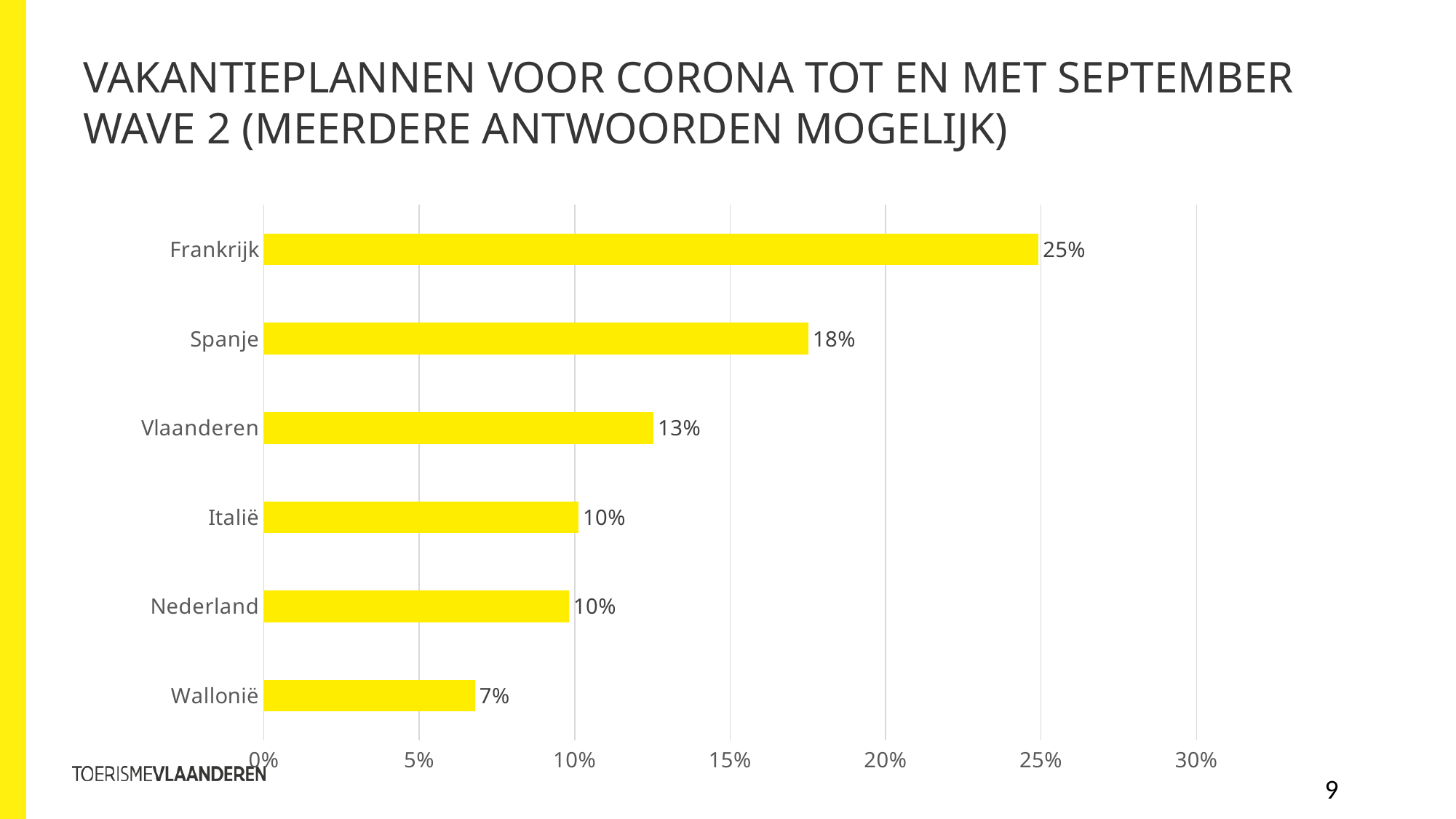
What is the value for Spanje? 18% What is the value for Vlaanderen? 13% How many categories are shown in the chart? 6 Which category has the highest value? Frankrijk Which category has the lowest value? Wallonië What is the difference between the values for Vlaanderen and Wallonië? 6% What kind of chart is shown on the slide? Bar chart What is the value for Frankrijk? 25% Which is larger, the value for Spanje or the value for Vlaanderen? Spanje Is the value for Spanje greater or less than 15%? greater What is the difference between the values for Frankrijk and Spanje? 7% What is the value for Wallonië? 7%